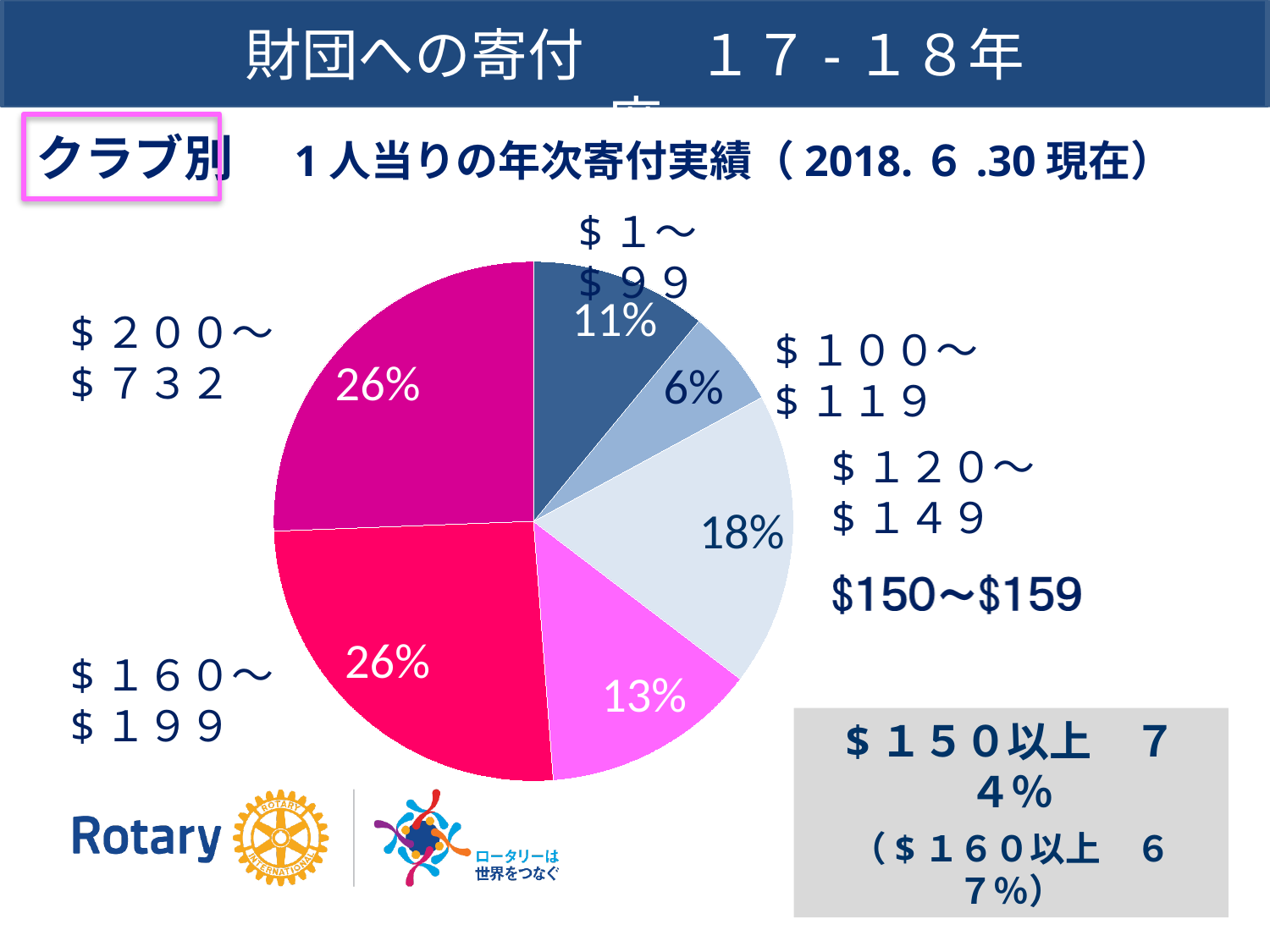
What is the difference in percentage points between the $120〜$149 slice and the $150〜$159 slice? 5 Which category has the smallest slice of the pie? $100〜$119 What share of the pie does the $200〜$732 category have? 26% What kind of chart is shown on the slide? pie chart What share of the pie does the $150〜$159 category have? 13% Which slice is larger, $120〜$149 or $150〜$159? $120〜$149 How many slices does the pie chart have? 6 What share of the pie does the $1〜$99 category have? 11% What share of the pie does the $120〜$149 category have? 18% What share of the pie does the $100〜$119 category have? 6% What is the difference in percentage points between the $160〜$199 slice and the $1〜$99 slice? 15 What share of the pie does the $160〜$199 category have? 26%